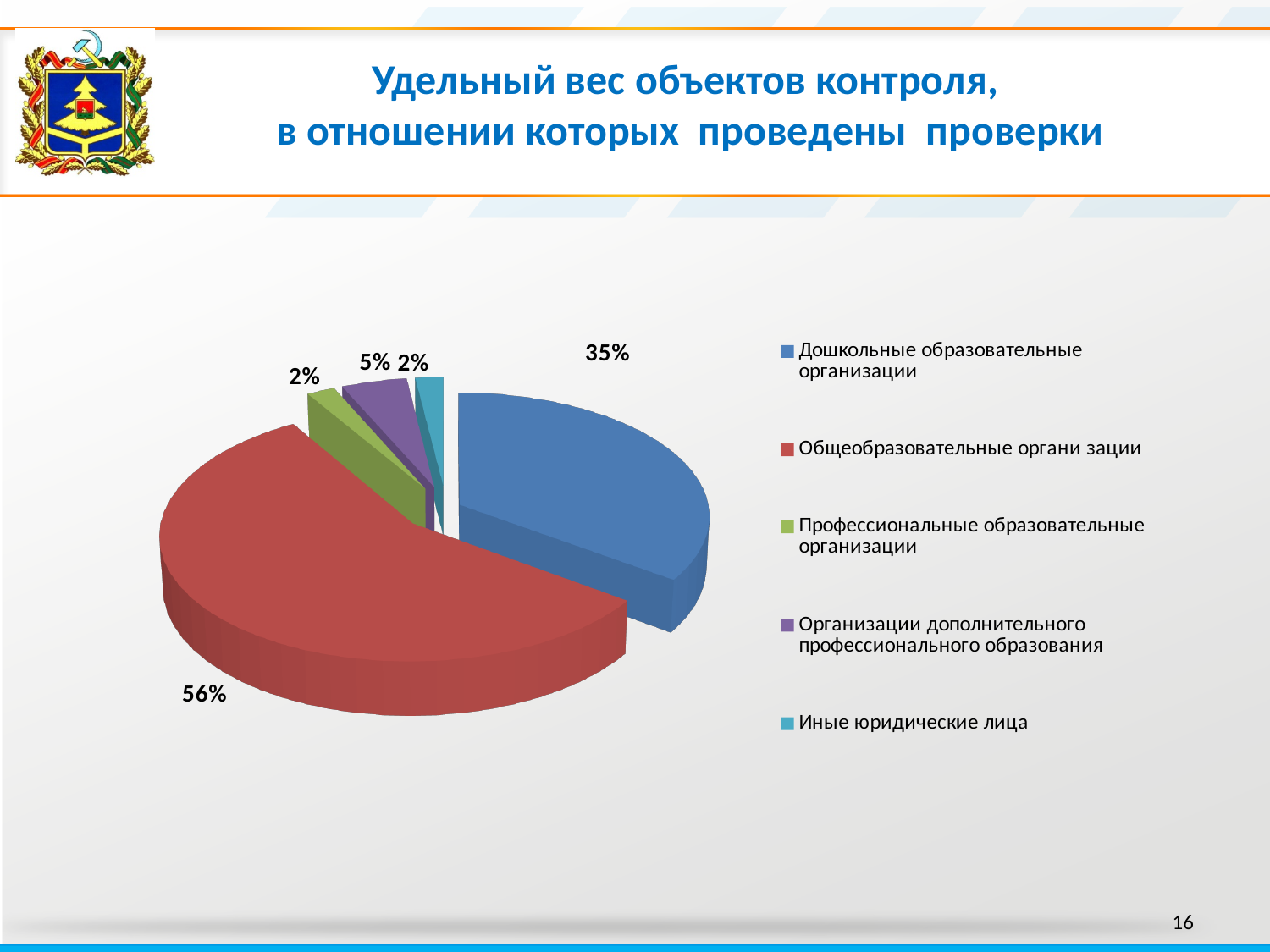
What share of the pie is labelled for Дошкольные образовательные организации? 35% What share of the pie is labelled for Общеобразовательные организации? 56% What colour is the slice for Общеобразовательные организации? Red How many entries does the legend list? 5 What type of chart is shown on the slide? Pie chart What share of the pie is labelled for Иные юридические лица? 2% What share of the pie is labelled for Профессиональные образовательные организации? 2% Which slice is larger: Дошкольные образовательные организации or Организации дополнительного профессионального образования? Дошкольные образовательные организации How many slices does the pie chart have? 5 What share of the pie is labelled for Организации дополнительного профессионального образования? 5% Which category has the largest slice of the pie? Общеобразовательные организации What is the difference in percentage points between the Общеобразовательные организации slice and the Дошкольные образовательные организации slice? 21 percentage points